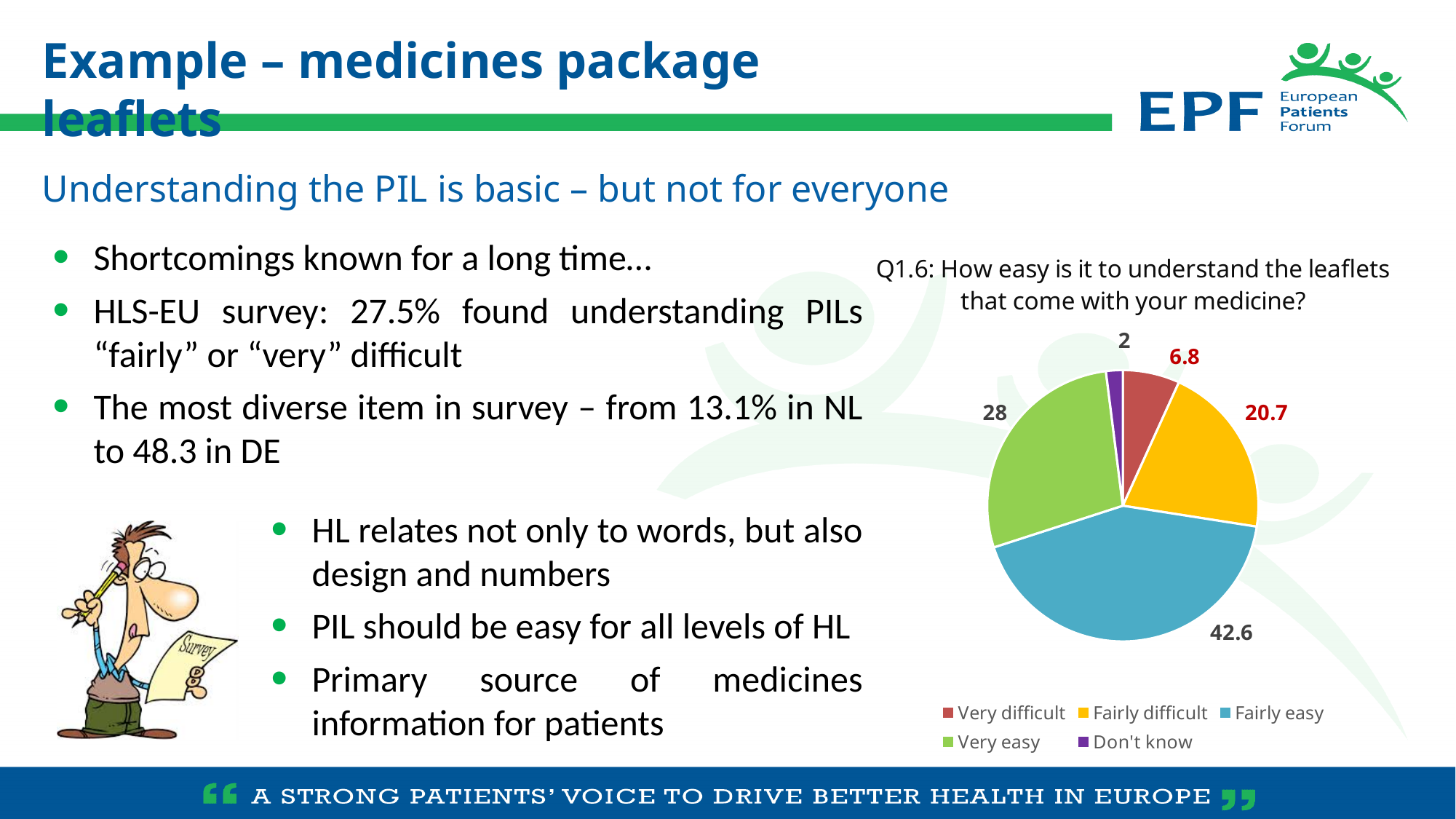
What is the value for "Fairly difficult" in the pie chart? 20.7 How many categories does the pie chart legend list? 5 What is the value for "Fairly easy" in the pie chart? 42.6 Which is larger, the value for "Fairly difficult" or the value for "Very easy"? Very easy What kind of chart is shown on the slide? Pie chart What is the value for "Very easy" in the pie chart? 28 Which category has the largest slice in the pie chart? Fairly easy What is the difference between the values for "Fairly easy" and "Very easy"? 14.6 Which category has the smallest slice in the pie chart? Don't know What is the value for "Don't know" in the pie chart? 2 What is the title of the pie chart? Q1.6: How easy is it to understand the leaflets that come with your medicine? What is the value for "Very difficult" in the pie chart? 6.8